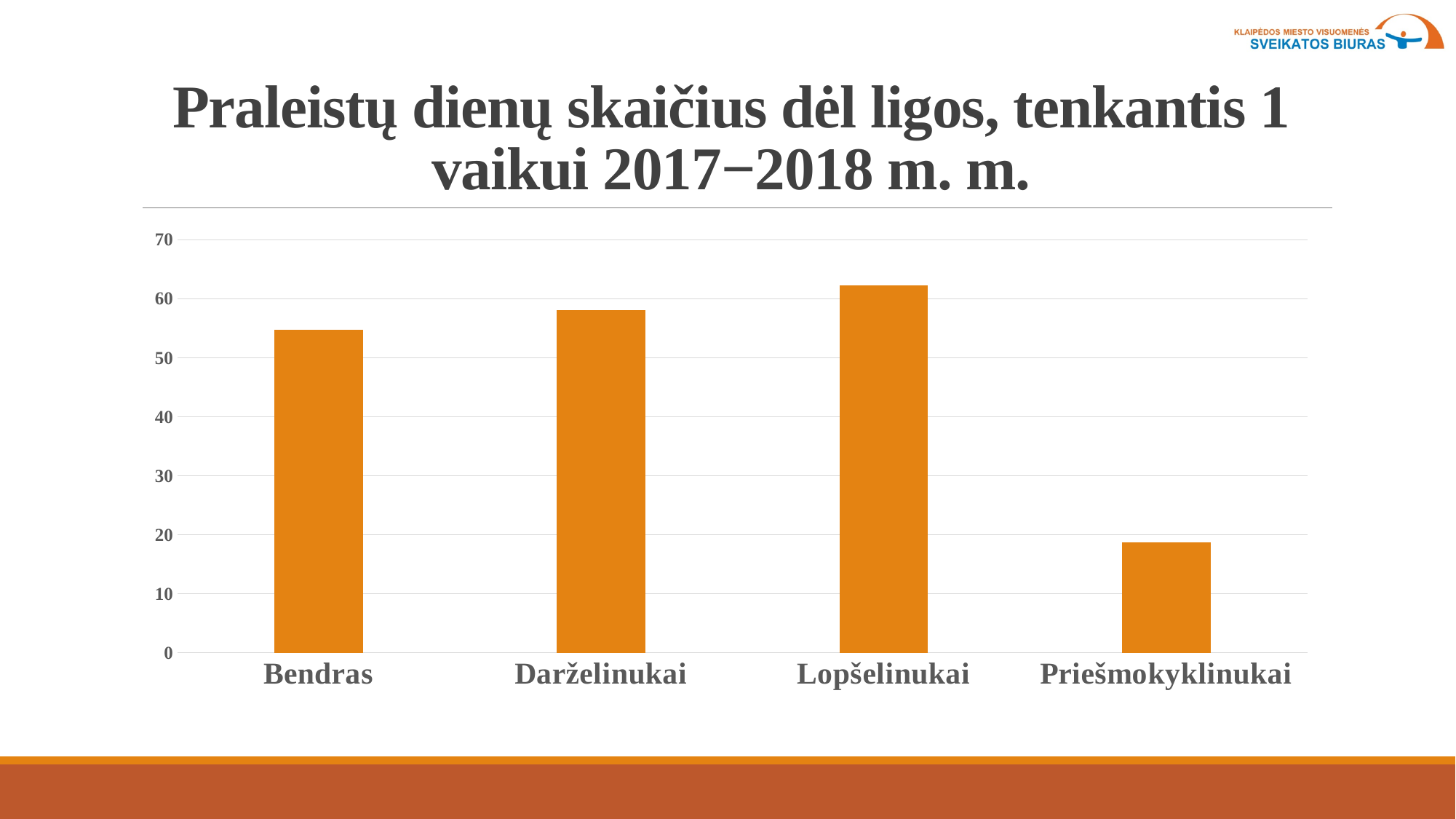
Which is larger, the value for Lopšelinukai or the value for Darželinukai? Lopšelinukai Is the value for Bendras greater or less than 60? less Which category has the highest bar in the chart? Lopšelinukai What kind of chart is shown on the slide? bar chart Is the value for Lopšelinukai greater or less than 50? greater What is the title of the chart on the slide? Praleistų dienų skaičius dėl ligos, tenkantis 1 vaikui 2017−2018 m. m. Is the value for Priešmokyklinukai greater or less than 30? less Which category has the lowest bar in the chart? Priešmokyklinukai How many categories are shown on the x axis of the chart? 4 Which is larger, the value for Priešmokyklinukai or the value for Bendras? Bendras